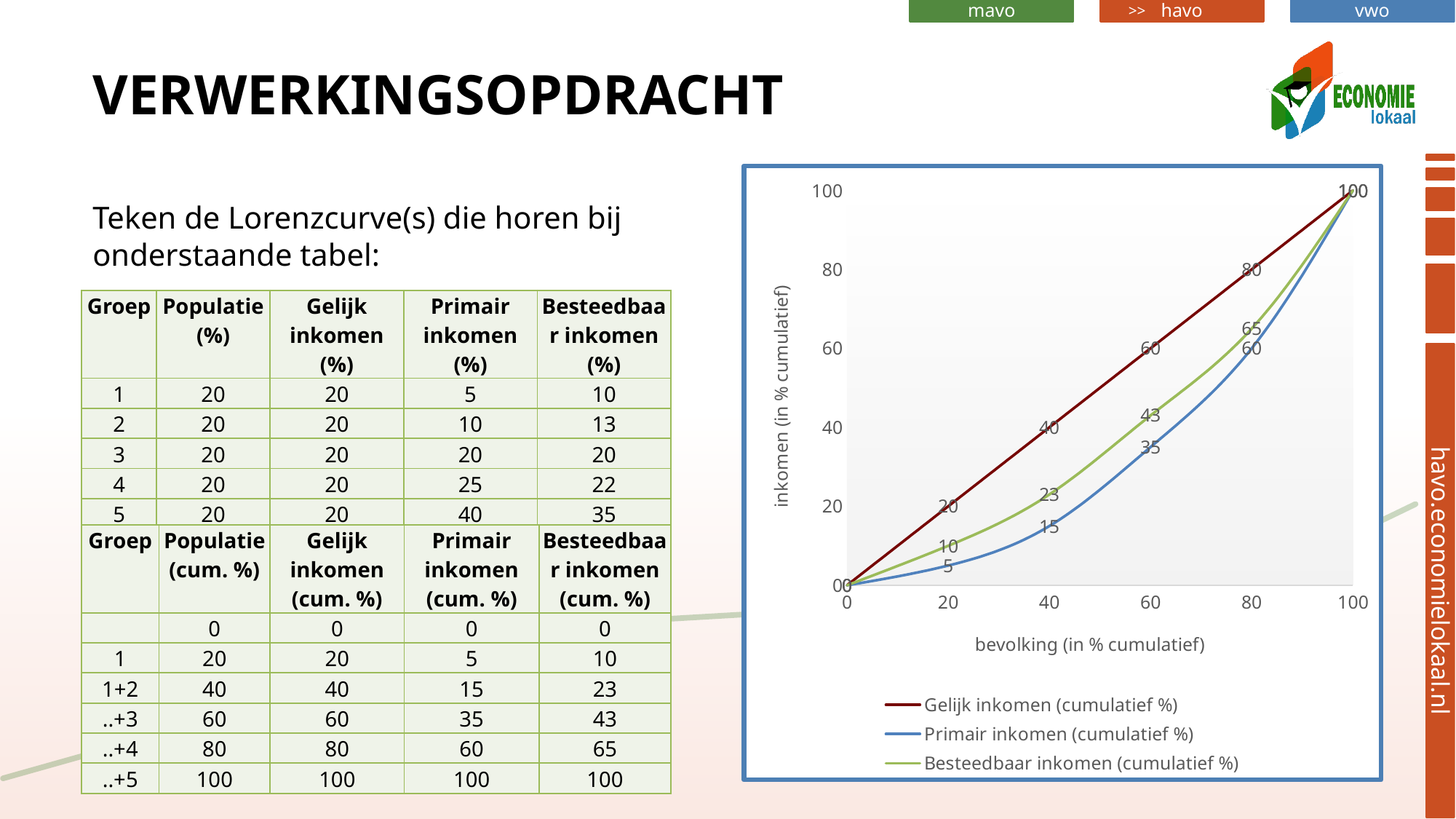
What is the difference between Besteedbaar inkomen and Primair inkomen at 60% of the population? 8 What is the value of Primair inkomen (cumulatief %) at 40% of the population? 15 How many series does the chart legend list? 3 What is the value of Besteedbaar inkomen (cumulatief %) at 60% of the population? 43 What is the value of Gelijk inkomen (cumulatief %) at 80% of the population? 80 Do the values of Primair inkomen rise or fall as the population percentage increases? rise At 80% of the population, which is larger: Besteedbaar inkomen or Primair inkomen? Besteedbaar inkomen What is the difference between Gelijk inkomen and Besteedbaar inkomen at 20% of the population? 10 Which series has the lowest value at 40% of the population? Primair inkomen (cumulatief %) What is the label of the x axis? bevolking (in % cumulatief) What type of chart is shown on the slide? line chart What is the value of Primair inkomen (cumulatief %) at 20% of the population? 5